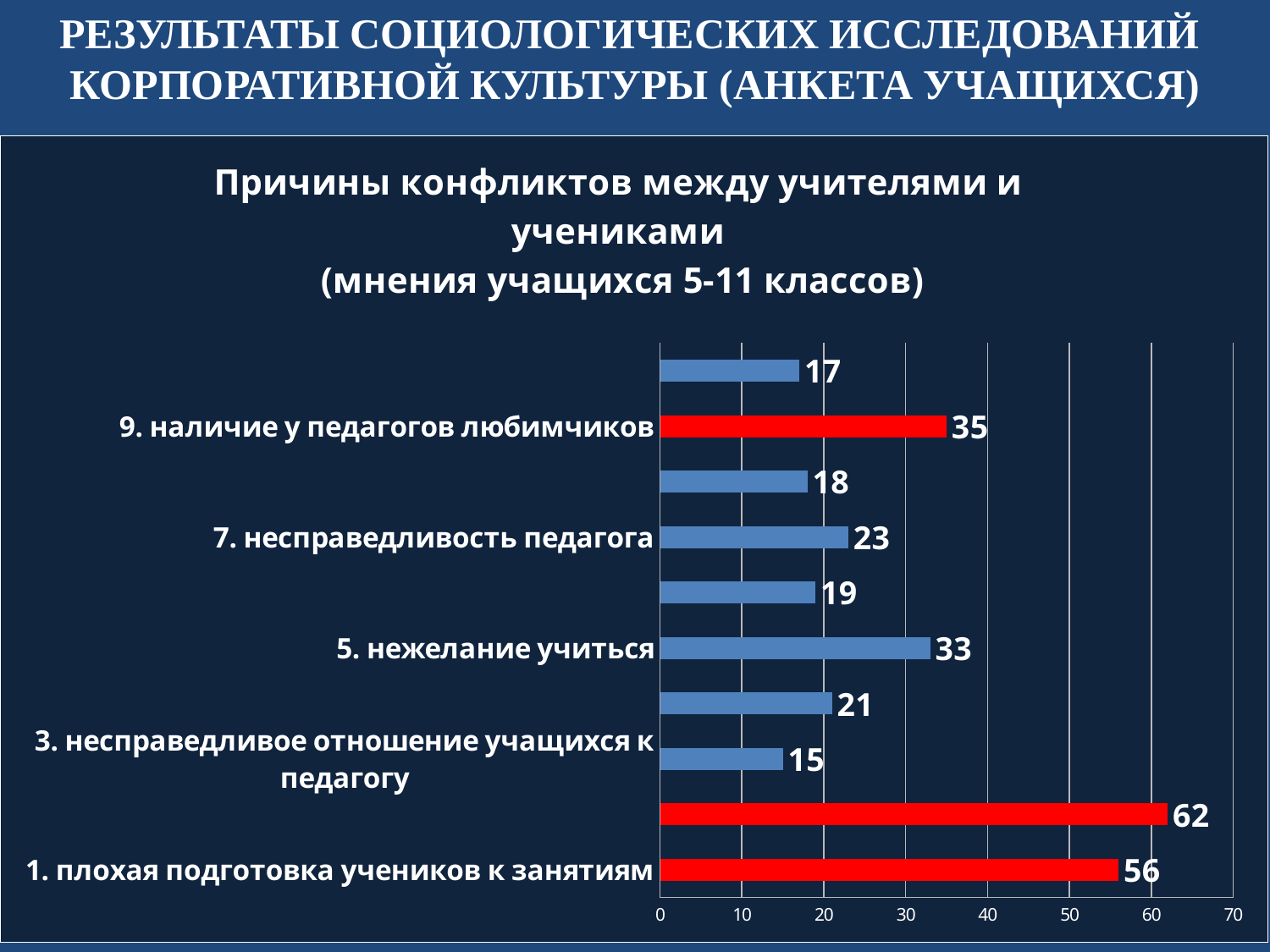
What is the value for "5. нежелание учиться"? 33 What is the difference between the values for "1. плохая подготовка учеников к занятиям" and "9. наличие у педагогов любимчиков"? 21 How many bars are plotted in the chart? 10 What is the value for "9. наличие у педагогов любимчиков"? 35 Is the value for "1. плохая подготовка учеников к занятиям" greater or less than 50? greater Which is larger: the value for "5. нежелание учиться" or the value for "7. несправедливость педагога"? 5. нежелание учиться How many bars in the chart are coloured red? 3 Which category has the lowest value in the chart? 3. несправедливое отношение учащихся к педагогу What is the value for "1. плохая подготовка учеников к занятиям"? 56 What is the value for "3. несправедливое отношение учащихся к педагогу"? 15 What is the value for "7. несправедливость педагога"? 23 What kind of chart is shown on the slide? bar chart